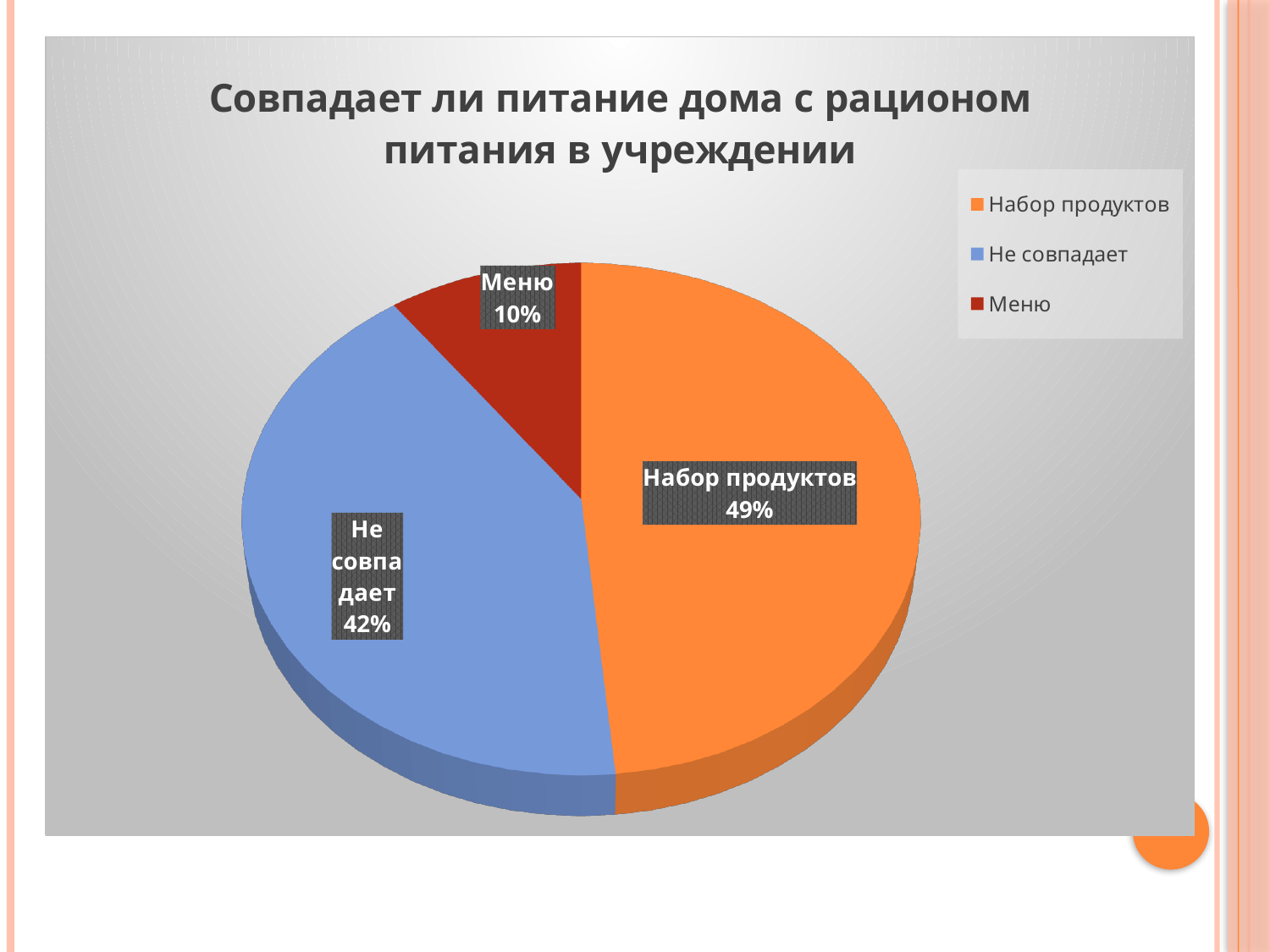
Which is larger, the share for "Не совпадает" or the share for "Меню"? Не совпадает What kind of chart is shown on the slide? pie chart Which category has the largest slice of the pie? Набор продуктов What share of the pie does "Не совпадает" have? 42% What is the difference in percentage points between "Набор продуктов" and "Не совпадает"? 7 What colour is the "Не совпадает" slice? blue What share of the pie does "Меню" have? 10% Which category has the smallest slice of the pie? Меню What is the title of the chart? Совпадает ли питание дома с рационом питания в учреждении How many entries does the legend list? 3 How many slices does the pie chart have? 3 What share of the pie does "Набор продуктов" have? 49%